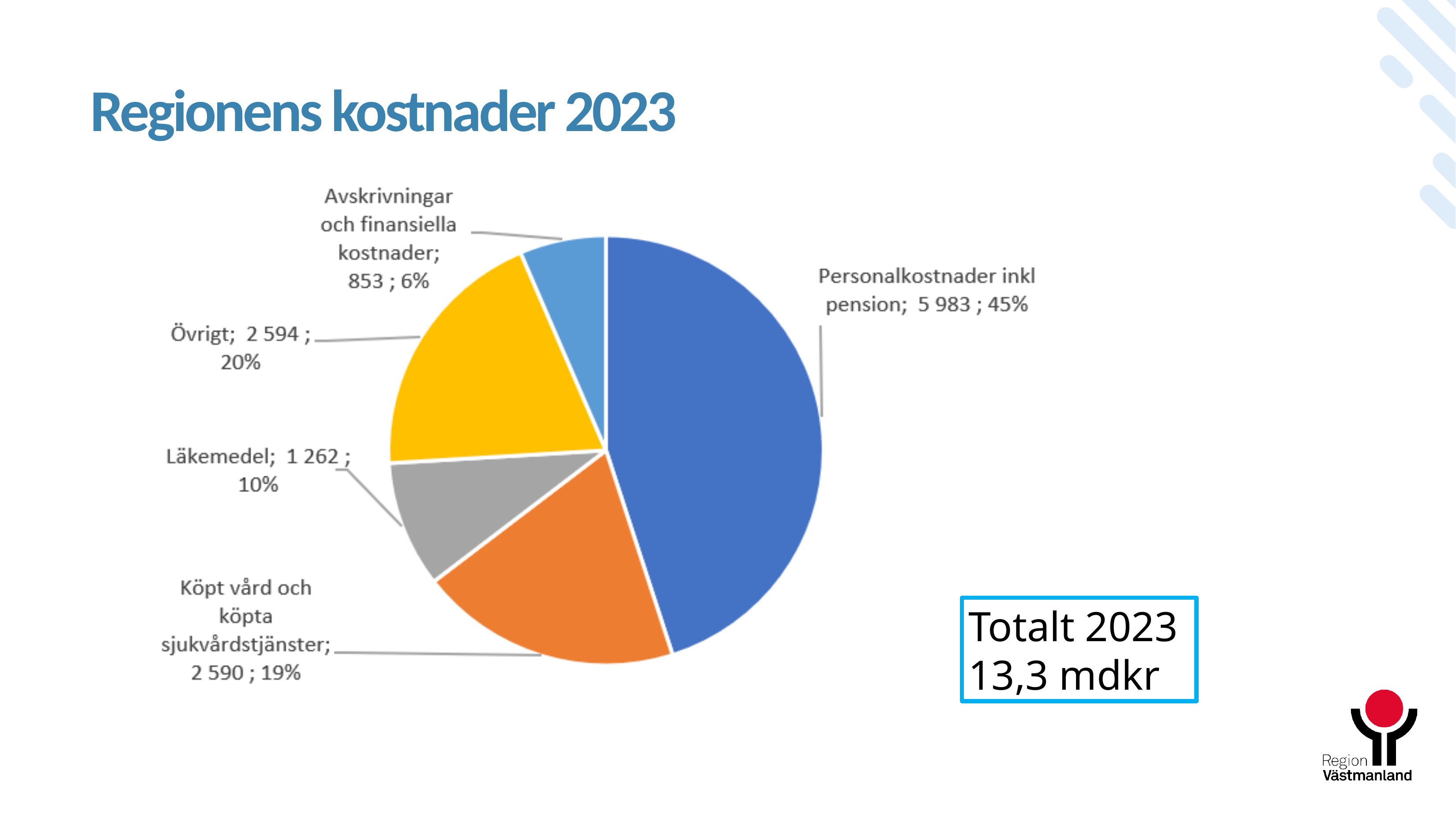
What is the value for Läkemedel? 1 262 What share of the pie does Övrigt represent? 20% What share of the pie does Köpt vård och köpta sjukvårdstjänster represent? 19% What is the title of the slide? Regionens kostnader 2023 What kind of chart is shown on the slide? pie chart Which category has the largest slice? Personalkostnader inkl pension What is the value for Personalkostnader inkl pension? 5 983 What is the value for Avskrivningar och finansiella kostnader? 853 Which category has the smallest slice? Avskrivningar och finansiella kostnader Which is larger, the value for Läkemedel or the value for Övrigt? Övrigt What is the difference between the values for Personalkostnader inkl pension and Läkemedel? 4 721 How many slices does the pie chart have? 5